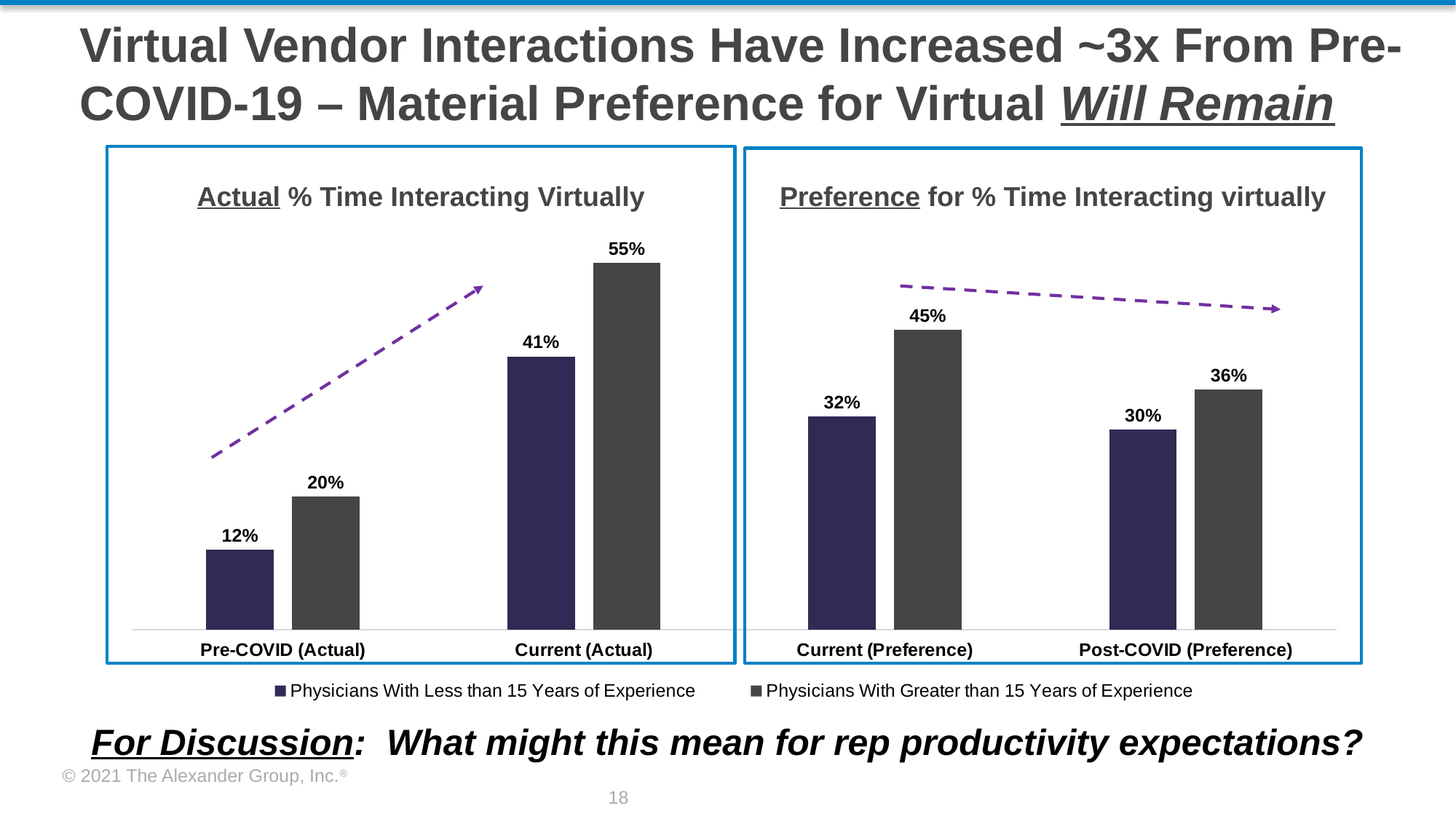
How many series does the legend list? 2 In the 'Preference for % Time Interacting virtually' chart, which bar has the lowest value? Physicians With Less than 15 Years of Experience, Post-COVID (Preference) In the 'Actual % Time Interacting Virtually' chart, what is the value for Physicians With Less than 15 Years of Experience in the Pre-COVID (Actual) category? 12% In the 'Preference for % Time Interacting virtually' chart, do the values rise or fall from Current (Preference) to Post-COVID (Preference)? Fall In the 'Actual % Time Interacting Virtually' chart, what is the difference between the Current (Actual) and Pre-COVID (Actual) values for Physicians With Greater than 15 Years of Experience? 35% In the 'Actual % Time Interacting Virtually' chart, what is the value for Physicians With Greater than 15 Years of Experience in the Current (Actual) category? 55% In the 'Preference for % Time Interacting virtually' chart, what is the value for Physicians With Greater than 15 Years of Experience in the Current (Preference) category? 45% In the 'Preference for % Time Interacting virtually' chart, what is the value for Physicians With Less than 15 Years of Experience in the Post-COVID (Preference) category? 30% In the 'Actual % Time Interacting Virtually' chart, which bar has the highest value? Physicians With Greater than 15 Years of Experience, Current (Actual) In the 'Preference for % Time Interacting virtually' chart, what is the difference between the two series in the Current (Preference) category? 13% In the 'Preference for % Time Interacting virtually' chart, which is larger: the Current (Preference) value or the Post-COVID (Preference) value for Physicians With Greater than 15 Years of Experience? Current (Preference) What kind of chart is the 'Actual % Time Interacting Virtually' chart? Bar chart